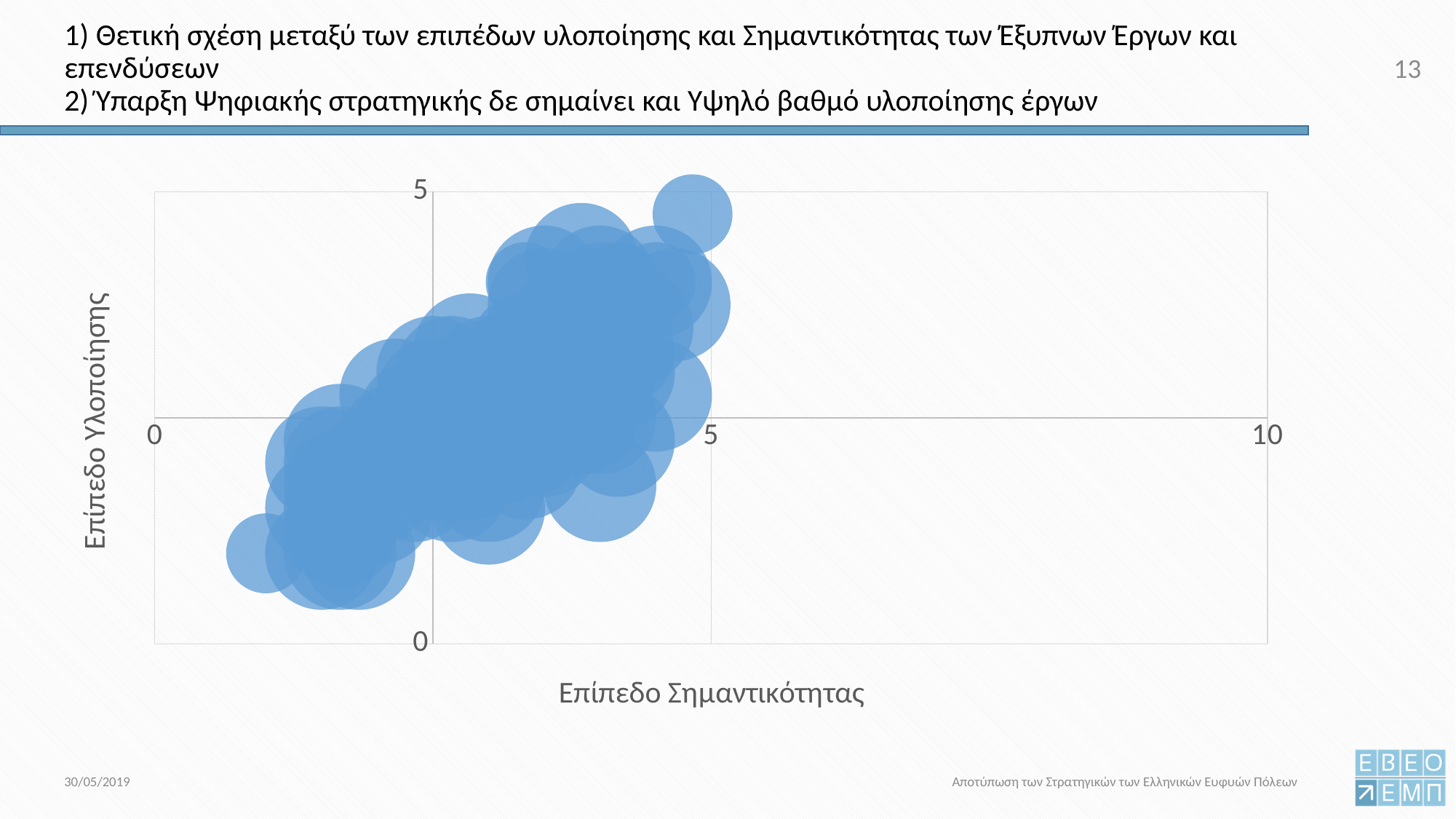
What kind of chart is shown on the slide? bubble chart As the value on the x axis (Επίπεδο Σημαντικότητας) increases, do the bubbles' values on the y axis (Επίπεδο Υλοποίησης) generally rise or fall? rise What is the title of the horizontal axis of the chart? Επίπεδο Σημαντικότητας Is the x-axis value of the rightmost bubble greater or less than 10? less What is the title of the vertical axis of the chart? Επίπεδο Υλοποίησης Is the x-axis value of the leftmost bubble greater or less than 5? less